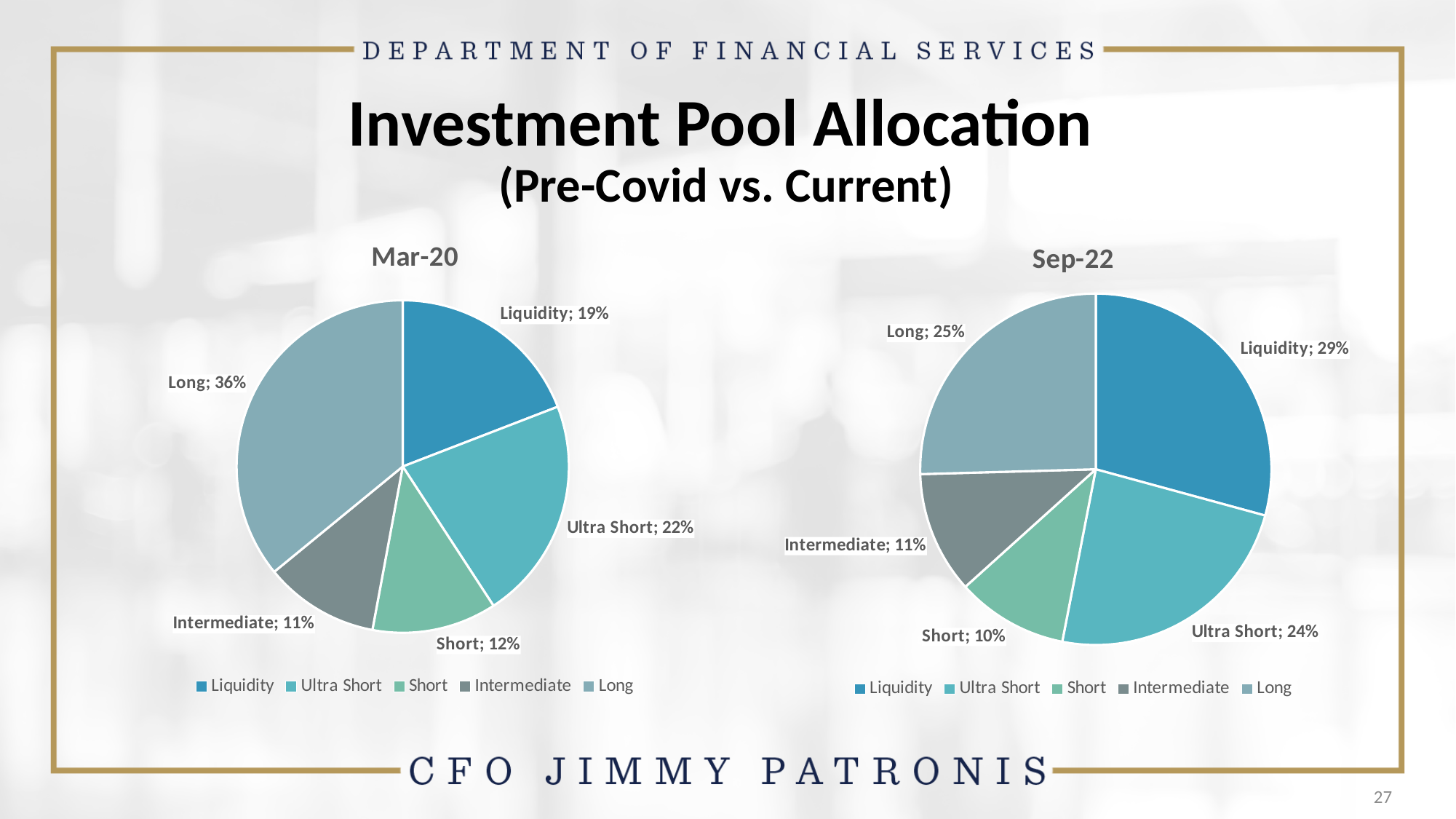
What is the difference between the Long share in Mar-20 and the Long share in Sep-22? 11 percentage points In the Mar-20 chart, which category has the largest slice? Long In the Sep-22 chart, what share does Short have? 10% Is the Liquidity share larger in the Mar-20 chart or the Sep-22 chart? Sep-22 In the Sep-22 chart, which category has the largest slice? Liquidity In the Mar-20 chart, what share does Long have? 36% How many categories does the Mar-20 pie chart have? 5 In the Sep-22 chart, what share does Liquidity have? 29% In the Sep-22 chart, which category has the smallest slice? Short What type of chart is the Sep-22 chart? Pie chart What is the title of the chart on the left? Mar-20 In the Mar-20 chart, what share does Ultra Short have? 22%